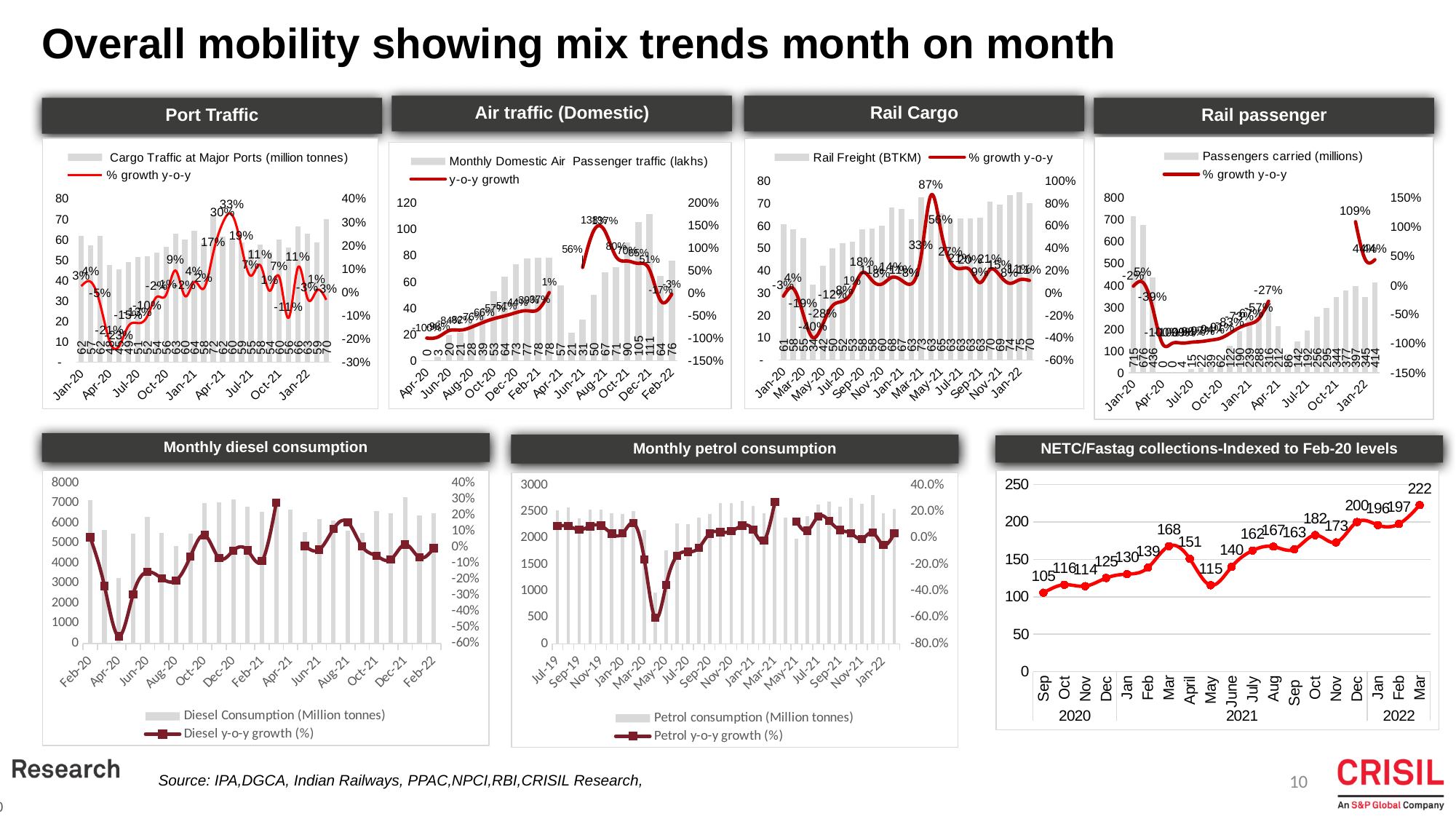
On the Rail passenger chart, what is the highest % growth y-o-y value labelled? 109% On the Rail Cargo chart, what is the highest % growth y-o-y value labelled? 87% On the NETC/Fastag collections chart, which month has the lowest value? Sep 2020 On the NETC/Fastag collections chart, what is the value for Mar 2022? 222 On the Port Traffic chart, what is the highest % growth y-o-y value labelled? 33% How many series does the legend of the Monthly diesel consumption chart list? 2 On the NETC/Fastag collections chart, which is larger, the value for Oct 2021 or the value for Nov 2021? Oct 2021 On the NETC/Fastag collections chart, what is the value for May 2021? 115 On the NETC/Fastag collections chart, how many data points are plotted? 19 On the NETC/Fastag collections chart, what is the difference between the Mar 2021 value and the May 2021 value? 53 On the NETC/Fastag collections chart, what is the value for Sep 2020? 105